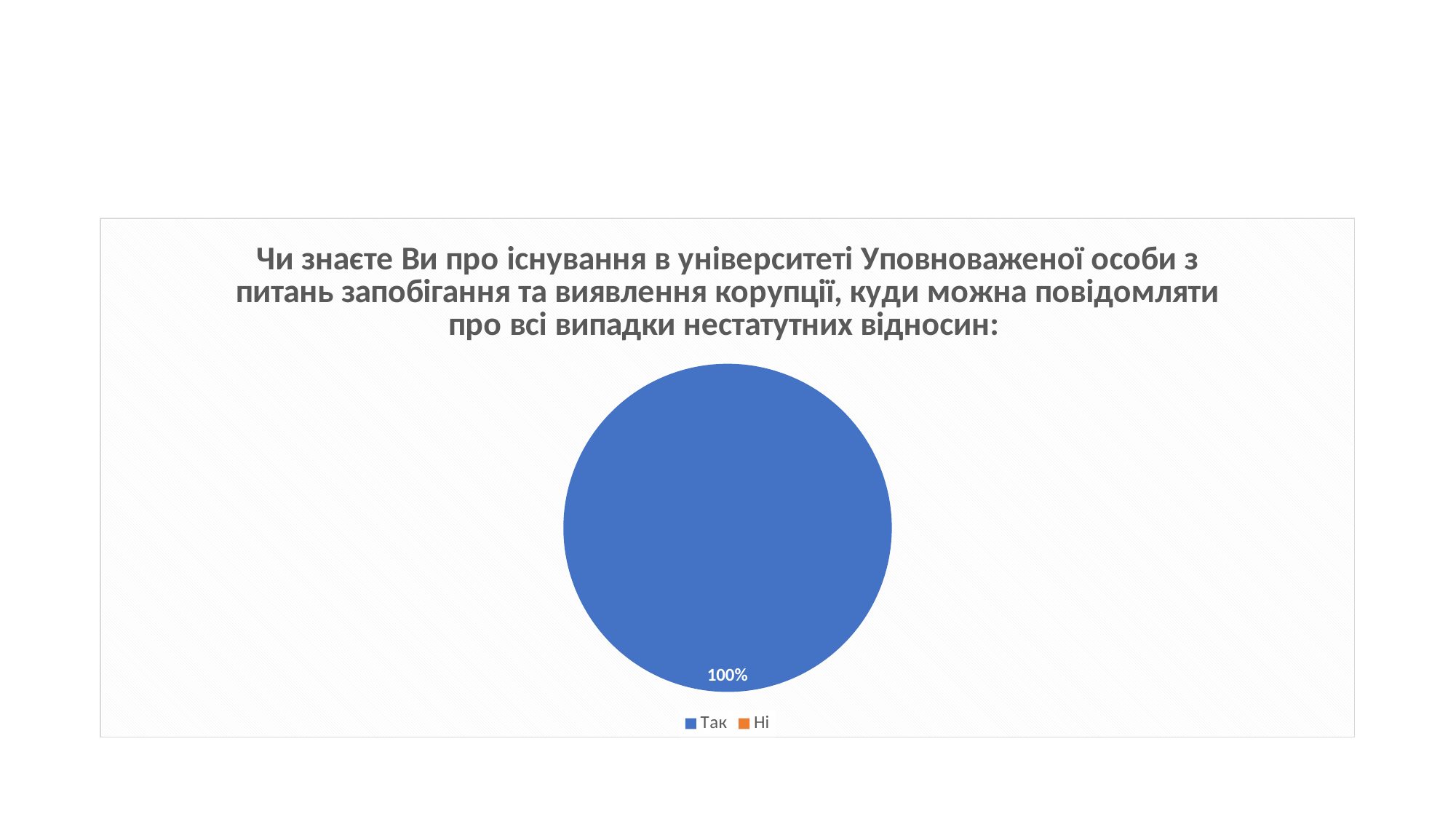
What share of the pie does the "Так" slice take? 100% What kind of chart is shown on the slide? pie chart Which category has the largest share of the pie? Так Which legend entry is shown in blue? Так How many entries does the legend list? 2 What is the only data label printed on the pie? 100% Which is larger, the share for "Так" or the share for "Ні"? Так Which legend entry is shown in orange? Ні Is the share for "Так" greater or less than 50%? greater